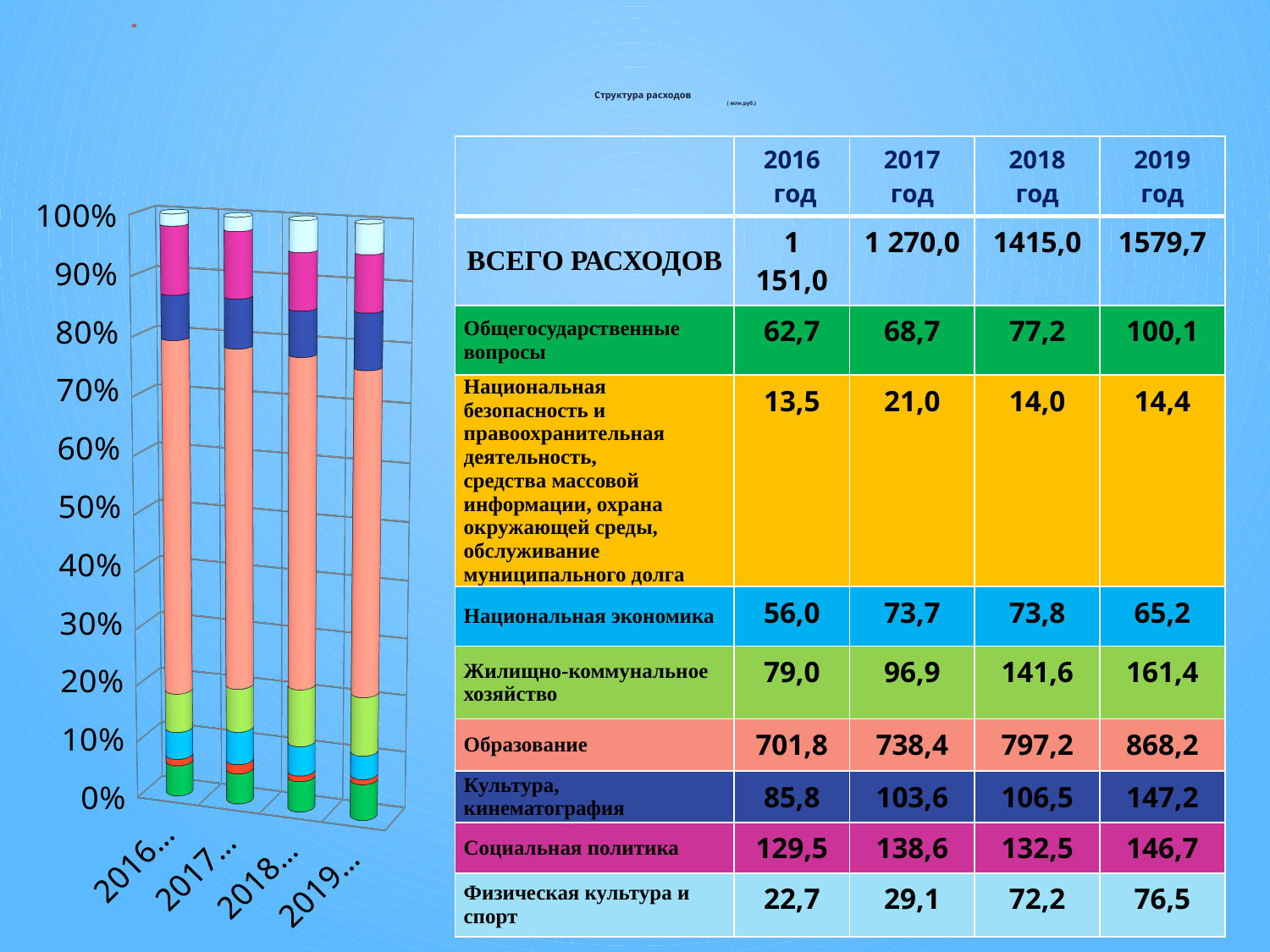
Is the top of the salmon-coloured segment in the 2019... bar above or below 70%? above Is the share of the largest (salmon-coloured) segment in the 2016... bar greater or less than 50%? greater What is the highest value shown on the chart's vertical axis? 100% How many coloured segments make up each stacked bar in the chart? 8 Which colour segment occupies the largest share of every bar in the chart? salmon (pink-orange) What kind of chart is shown on the left of the slide? stacked bar chart How many bars (categories) does the chart show? 4 What is the label of the first category on the x axis of the chart? 2016... Is the bottom green segment of the 2016... bar greater or less than 10% of the bar? less